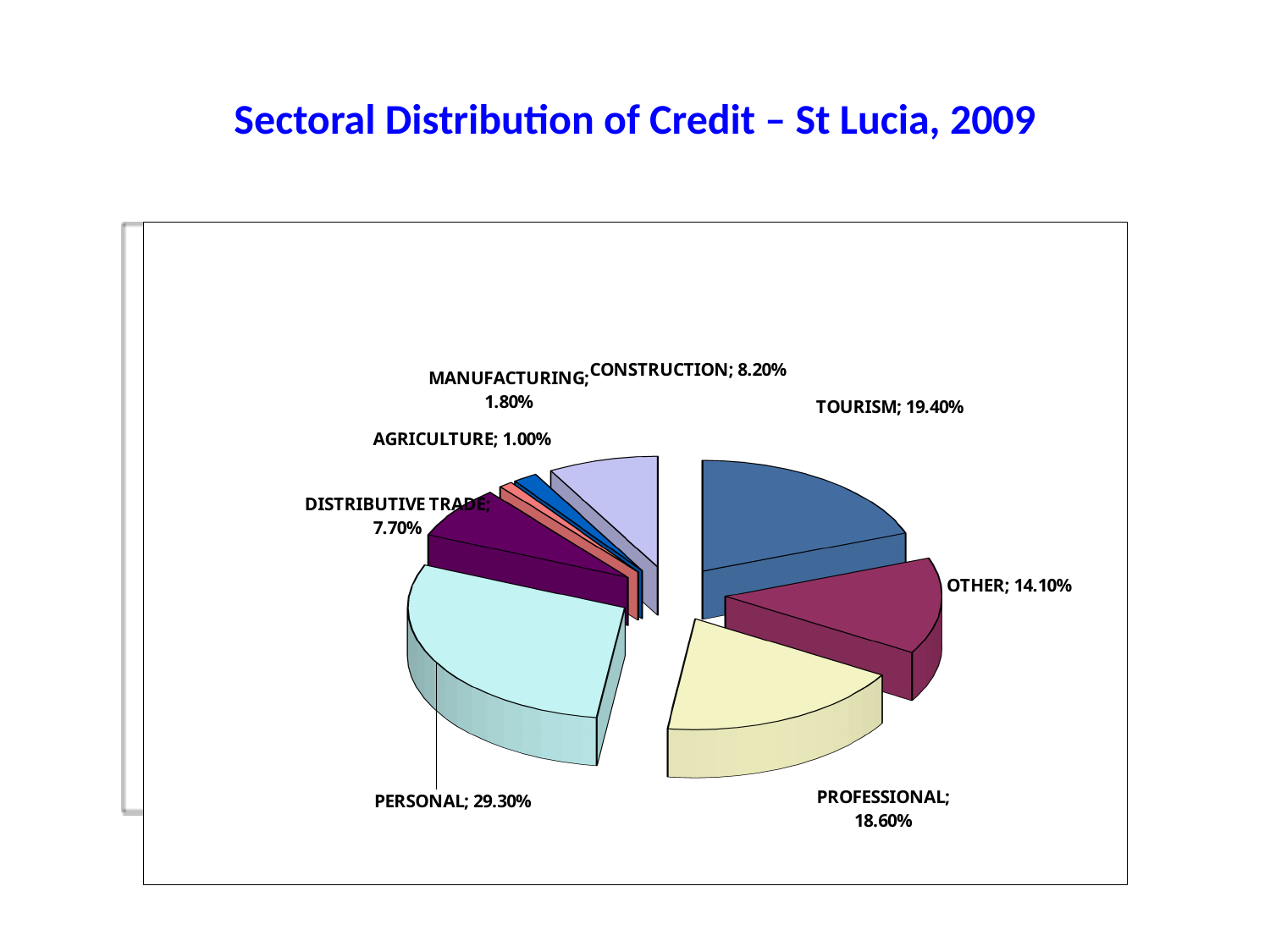
What share of credit goes to Distributive Trade? 7.70% Which has a larger share of credit, Tourism or Professional? Tourism What is the title of the chart? Sectoral Distribution of Credit – St Lucia, 2009 What is the difference between the Construction share and the Manufacturing share? 6.40% Which sector has the smallest share of credit? Agriculture Which sector has the largest share of credit? Personal What is the difference between the Personal share and the Tourism share? 9.90% What share of credit goes to Agriculture? 1.00% How many sectors are shown in the pie chart? 8 What share of credit goes to Tourism? 19.40% What share of credit goes to the Personal sector? 29.30% What kind of chart is shown on the slide? Pie chart